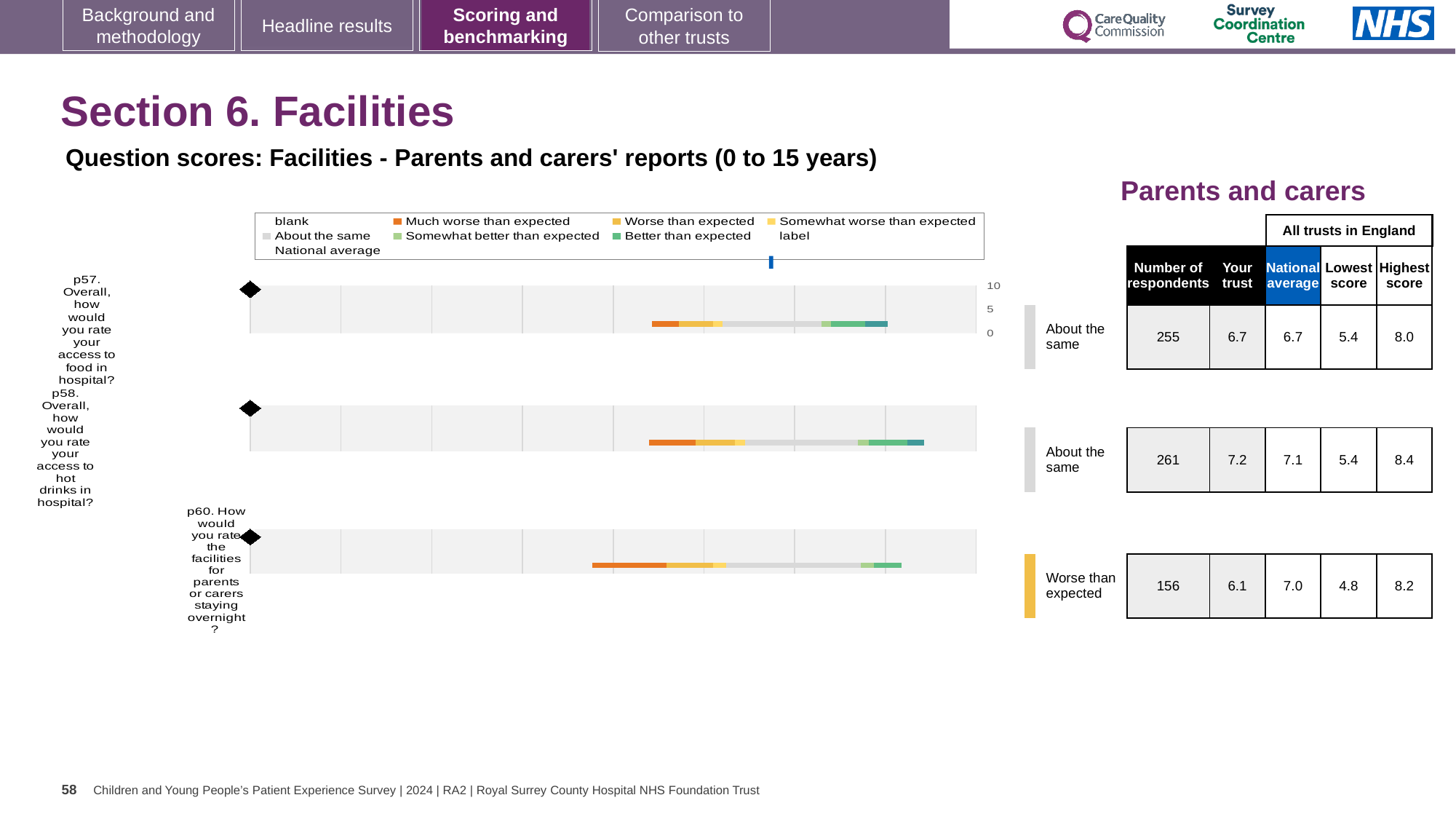
What is the national average score for p58 (access to hot drinks in hospital)? 7.1 What kind of chart is used to show the question scores for Facilities? Bar chart How many respondents answered p60 (facilities for parents or carers staying overnight)? 156 Which question has the highest 'Your trust' score? p58 (access to hot drinks in hospital) For p58, how much higher is the 'Your trust' score than the national average? 0.1 For p60, which is larger: the 'Your trust' score or the national average? National average What is the 'Your trust' score for p57 (access to food in hospital)? 6.7 Which question has the lowest 'Your trust' score? p60 (facilities for parents or carers staying overnight) What benchmark category is shown for p60 (facilities for parents or carers staying overnight)? Worse than expected For p57, what is the difference between the highest and lowest scores among all trusts in England? 2.6 How many questions are plotted in the Facilities question scores chart? 3 What is the highest score among all trusts in England for p58? 8.4